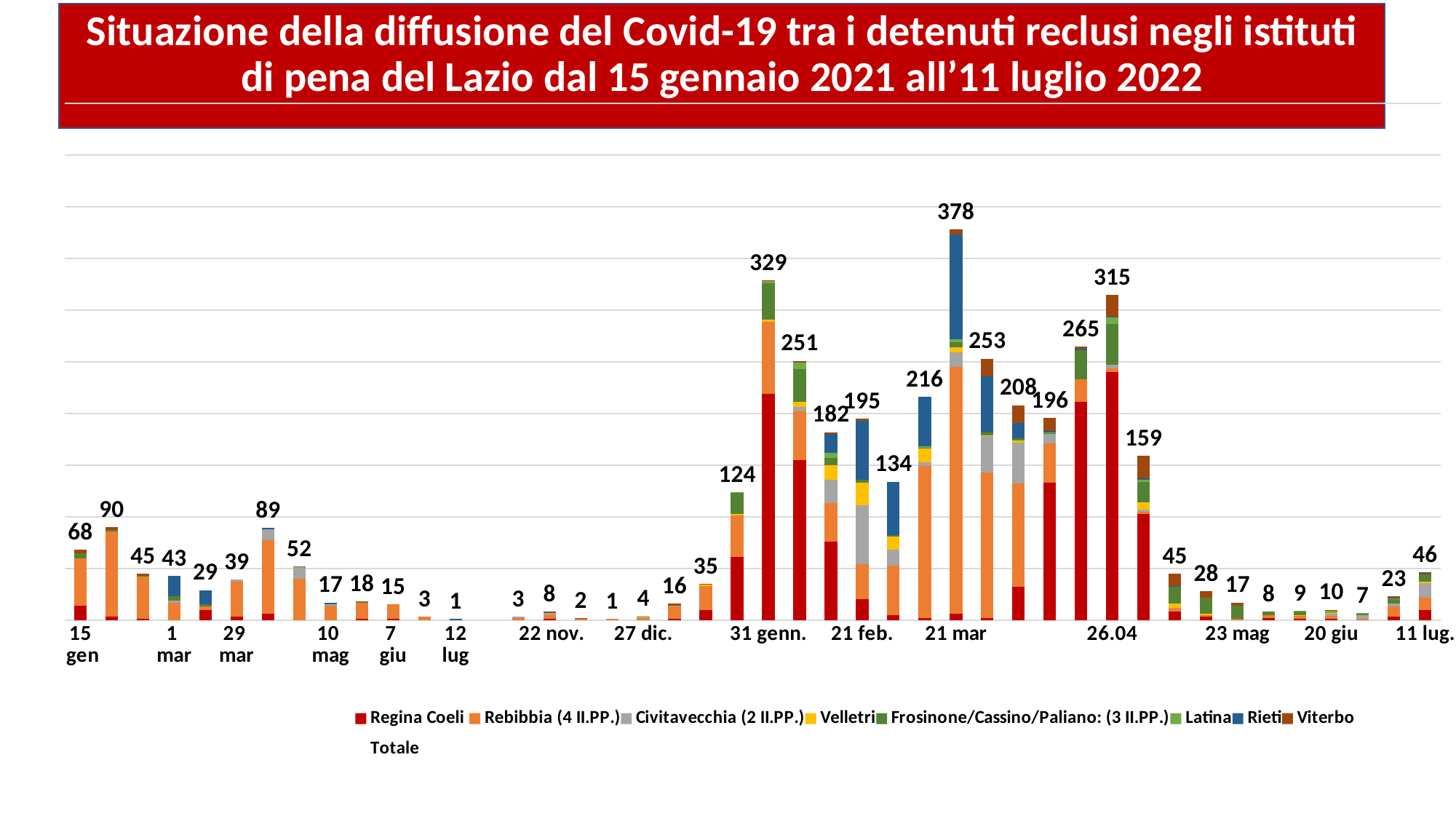
Which has a larger total, 31 genn. or 26.04? 31 genn. What is the difference between the totals for 21 mar and 31 genn.? 49 What is the total shown for 12 lug? 1 What is the total shown for 11 lug.? 46 What is the total number of Covid-19 cases among detainees shown for 15 gen? 68 What kind of chart is shown on the slide? Stacked bar chart Which date has the highest total on the chart? 21 mar What total value is labelled on the bar for 21 mar? 378 What is the difference between the totals for 26.04 and 11 lug.? 269 How many entries does the legend list? 9 What total is labelled on the bar for 26.04? 315 What is the total shown for 31 genn.? 329